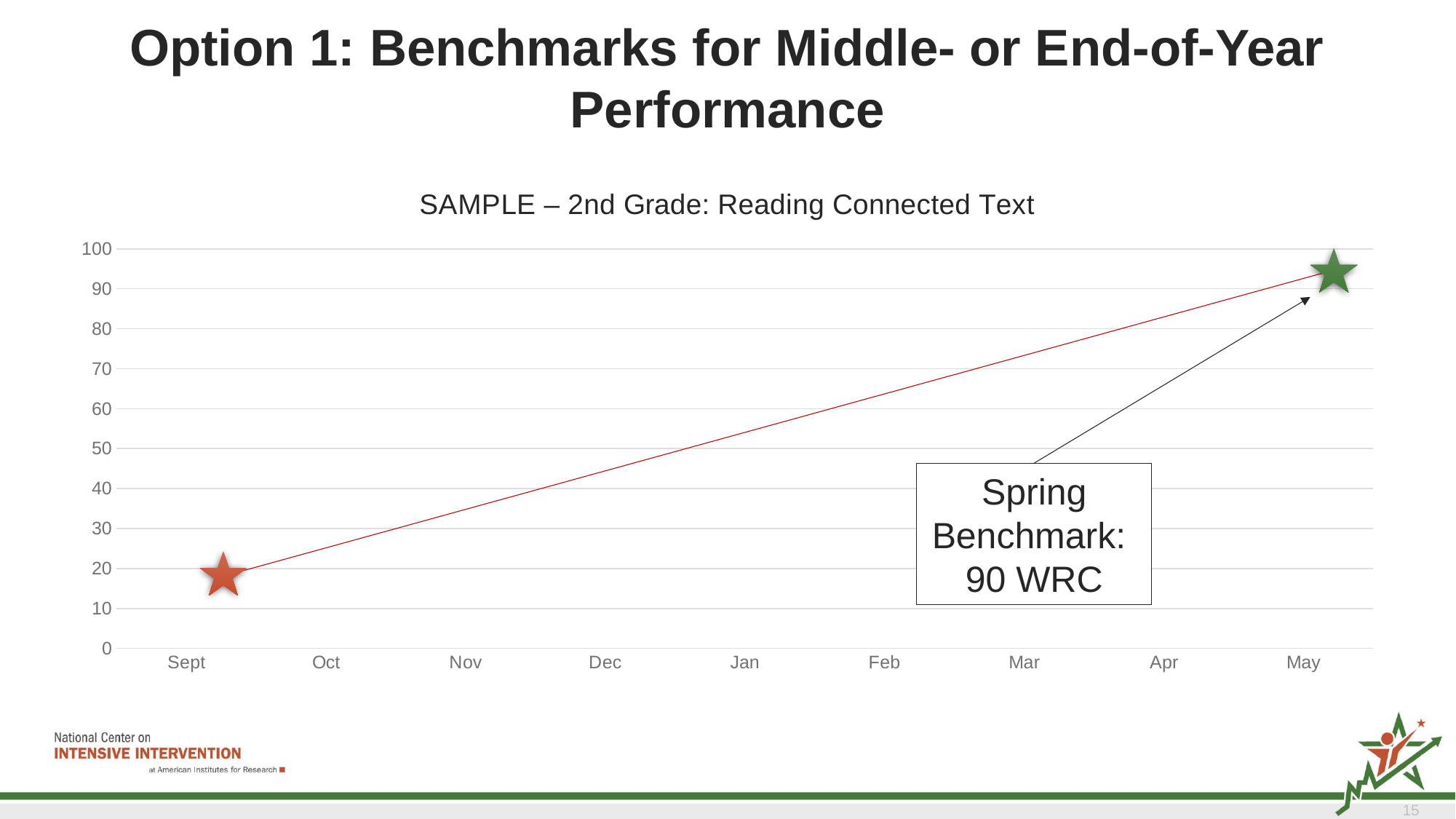
According to the annotation box, what is the Spring Benchmark value? 90 WRC What is the highest value shown on the y axis? 100 Which is larger, the value plotted for Sept or the value plotted for May? May Is the value plotted for May greater or less than 80? greater How many data points (stars) are plotted on the line? 2 What kind of chart is shown on the slide? line chart Is the value plotted for Sept greater or less than 30? less Which month has the highest plotted value? May Does the line rise or fall from Sept to May? rises What is the title of the chart? SAMPLE – 2nd Grade: Reading Connected Text Which month has the lowest plotted value? Sept How many months are labelled along the x axis of the chart? 9